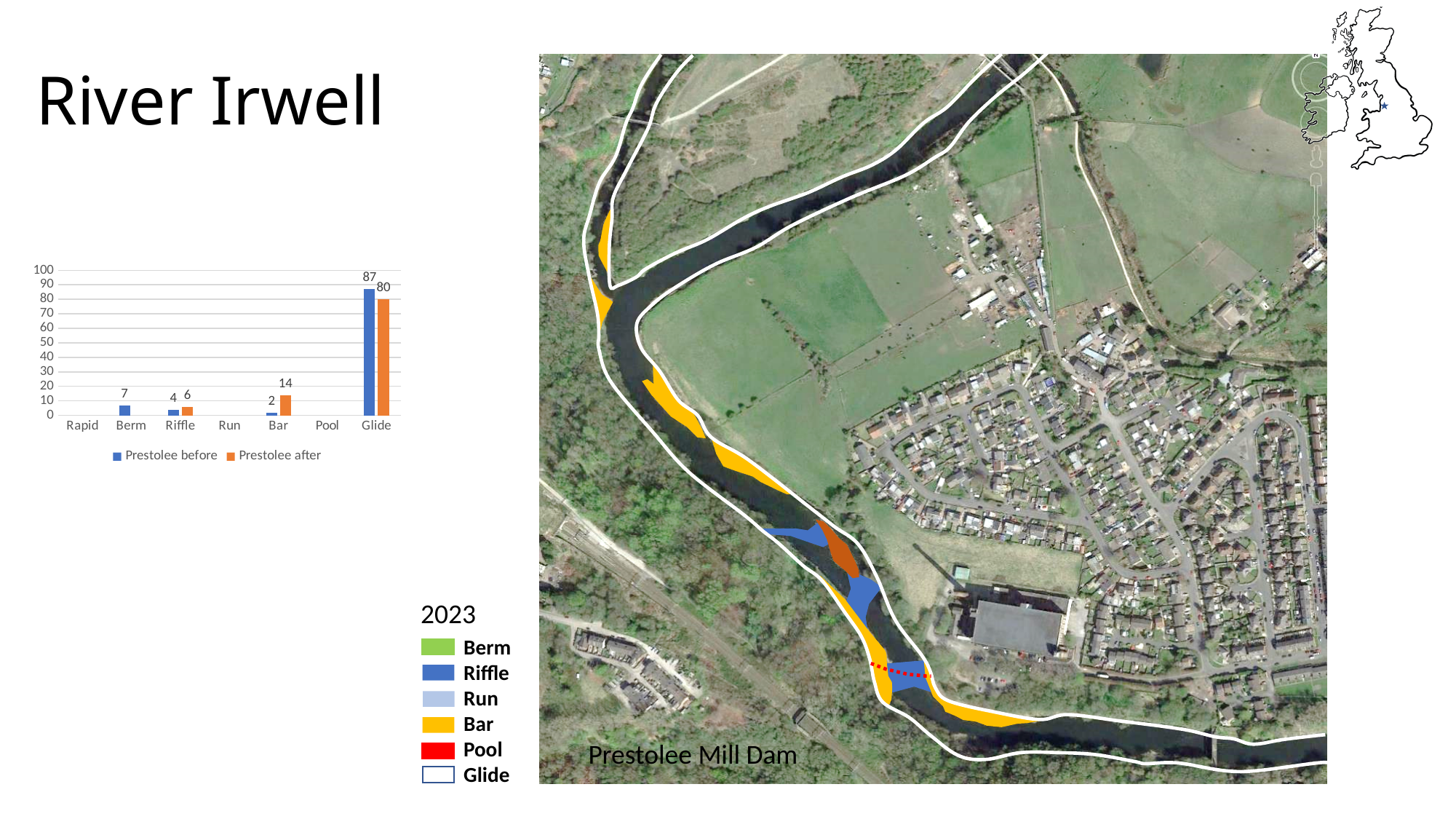
What is the Prestolee before value for Berm? 7 How many series does the chart legend list? 2 What is the difference between the Prestolee after and Prestolee before values for Bar? 12 How many categories are shown on the x axis of the chart? 7 What are the two series named in the chart legend? Prestolee before, Prestolee after What kind of chart is shown on the slide? bar chart What is the difference between the Prestolee before and Prestolee after values for Glide? 7 What is the Prestolee before value for Glide? 87 What is the Prestolee after value for Bar? 14 What is the Prestolee after value for Glide? 80 Which category has the highest Prestolee before value? Glide For Riffle, which is larger: the Prestolee before value or the Prestolee after value? Prestolee after